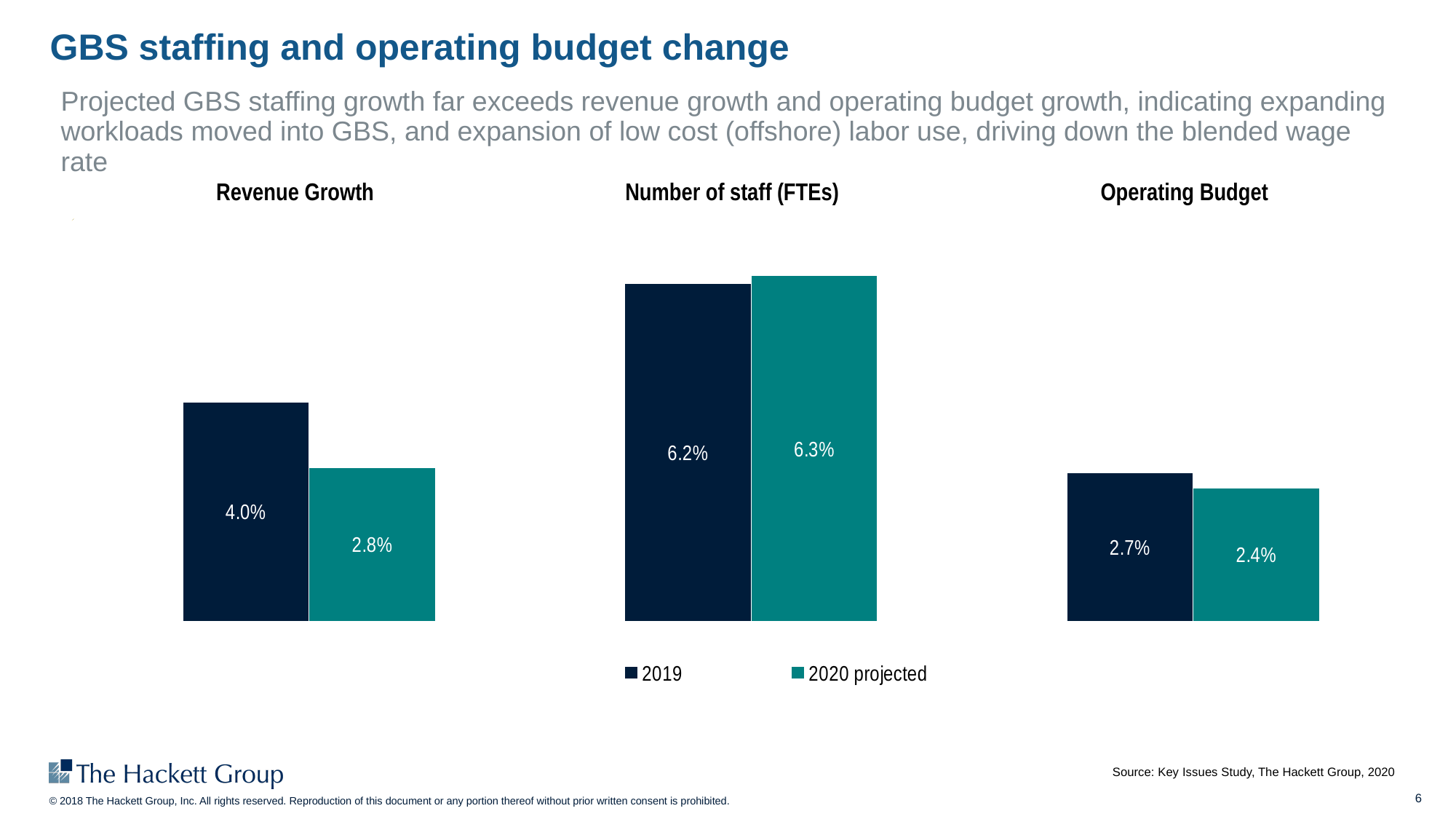
How many series does the legend list? 2 What kind of chart is the Operating Budget chart? Bar chart In the Revenue Growth chart, what is the value for 2019? 4.0% In the Number of staff (FTEs) chart, what is the value for 2020 projected? 6.3% In the Number of staff (FTEs) chart, what is the value for 2019? 6.2% In the Operating Budget chart, what is the value for 2020 projected? 2.4% In the Number of staff (FTEs) chart, which is larger, the 2019 value or the 2020 projected value? 2020 projected In the Revenue Growth chart, what is the difference between the 2019 and 2020 projected values? 1.2% In the Operating Budget chart, what is the value for 2019? 2.7% In the Revenue Growth chart, what is the value for 2020 projected? 2.8% In the Revenue Growth chart, which is larger, the 2019 value or the 2020 projected value? 2019 In the Operating Budget chart, what is the difference between the 2019 and 2020 projected values? 0.3%